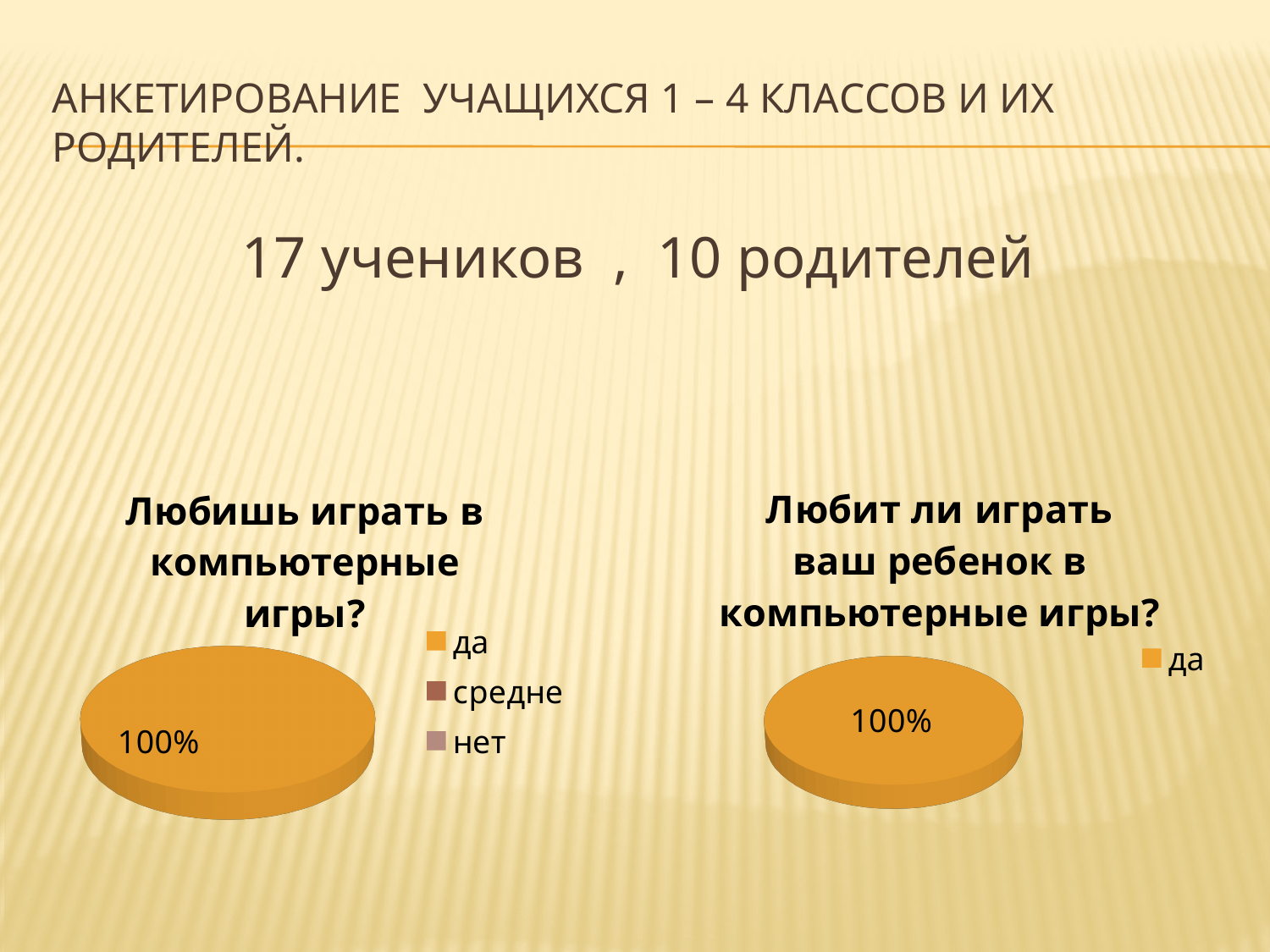
What are the three legend entries of the left chart "Любишь играть в компьютерные игры?"? да, средне, нет What kind of chart is the right chart titled "Любит ли играть ваш ребенок в компьютерные игры?"? pie chart In the left chart "Любишь играть в компьютерные игры?", is the share for "да" greater or less than 50%? greater How many entries does the legend of the left chart "Любишь играть в компьютерные игры?" list? 3 In the left chart "Любишь играть в компьютерные игры?", which legend category does the 100% slice belong to? да In the left chart "Любишь играть в компьютерные игры?", what share of the pie is labelled? 100% What kind of chart is the left chart titled "Любишь играть в компьютерные игры?"? pie chart In the right chart "Любит ли играть ваш ребенок в компьютерные игры?", what value is printed on the pie? 100% How many charts are shown on the slide? 2 What is the title of the chart on the right side of the slide? Любит ли играть ваш ребенок в компьютерные игры? In the right chart "Любит ли играть ваш ребенок в компьютерные игры?", which category makes up 100% of the pie? да How many entries does the legend of the right chart "Любит ли играть ваш ребенок в компьютерные игры?" list? 1